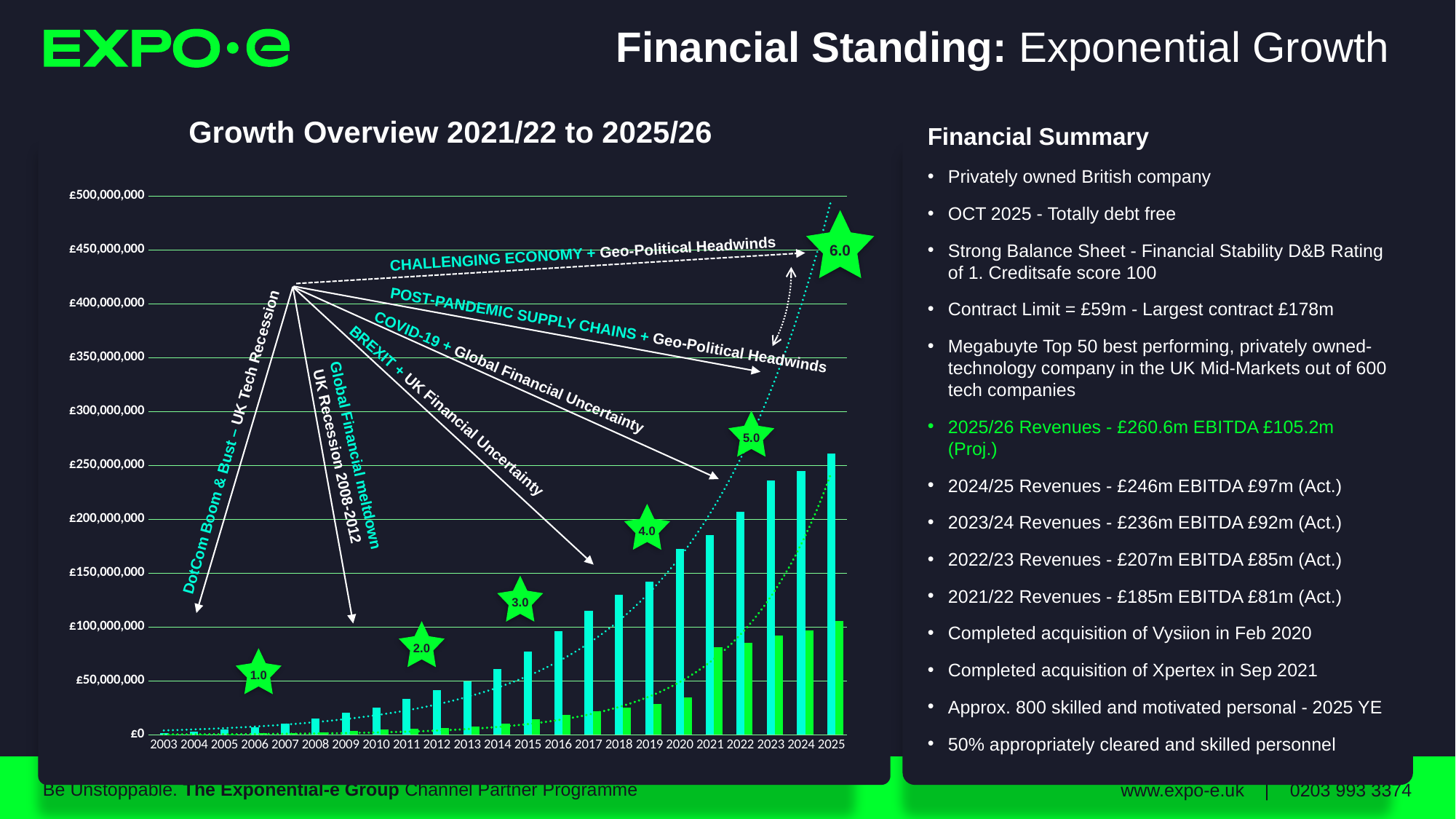
Which year has the shortest bars in the Growth Overview chart? 2003 Which year has the tallest bar in the Growth Overview chart? 2025 Is the taller bar for 2019 greater or less than £150,000,000? less Which year has the taller bar, 2020 or 2025? 2025 Is the taller bar for 2021 greater or less than £150,000,000? greater What is the title of the chart on the slide? Growth Overview 2021/22 to 2025/26 Is the taller bar for 2023 greater or less than £250,000,000? less What kind of chart is the Growth Overview chart? bar chart Do the bar heights generally rise or fall from 2003 to 2025? rise How many years are shown on the x axis of the Growth Overview chart? 23 What is the highest value labelled on the y axis of the chart? £500,000,000